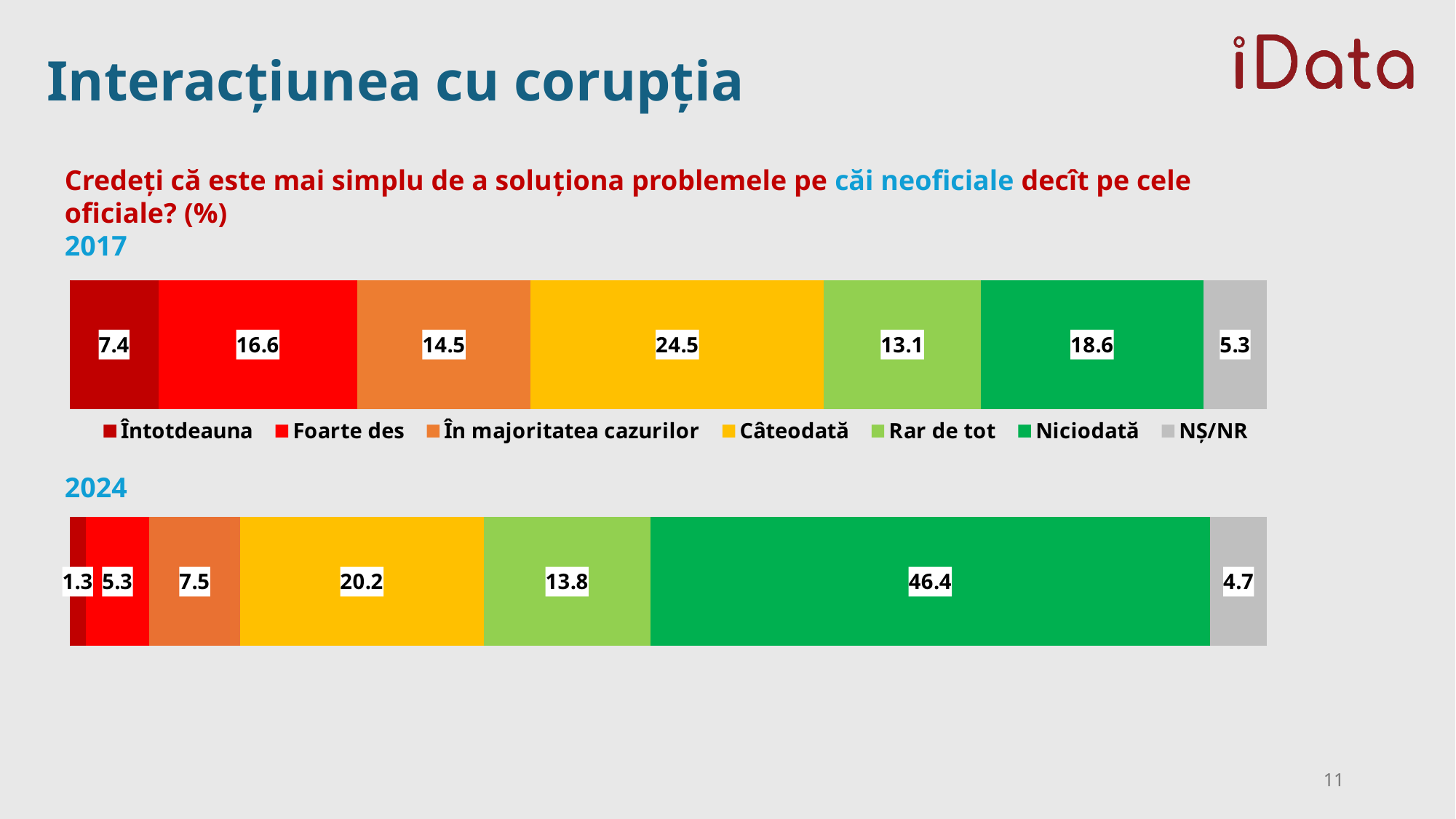
In the 2017 chart, which is larger: Foarte des or În majoritatea cazurilor? Foarte des In the 2024 chart, which category has the lowest value? Întotdeauna What is the total of the 2024 stacked bar? 99.2 In the 2024 chart, what is the value for NȘ/NR? 4.7 Which colour represents Niciodată in the legend? Green In the 2017 chart, what is the value for Întotdeauna? 7.4 How many series does the legend list? 7 In the 2017 chart, what is the value for Câteodată? 24.5 What kind of chart is used for the 2017 data? Stacked bar chart What is the difference between the Niciodată value in the 2024 chart and the Niciodată value in the 2017 chart? 27.8 In the 2017 chart, which category has the highest value? Câteodată In the 2024 chart, what is the value for Niciodată? 46.4